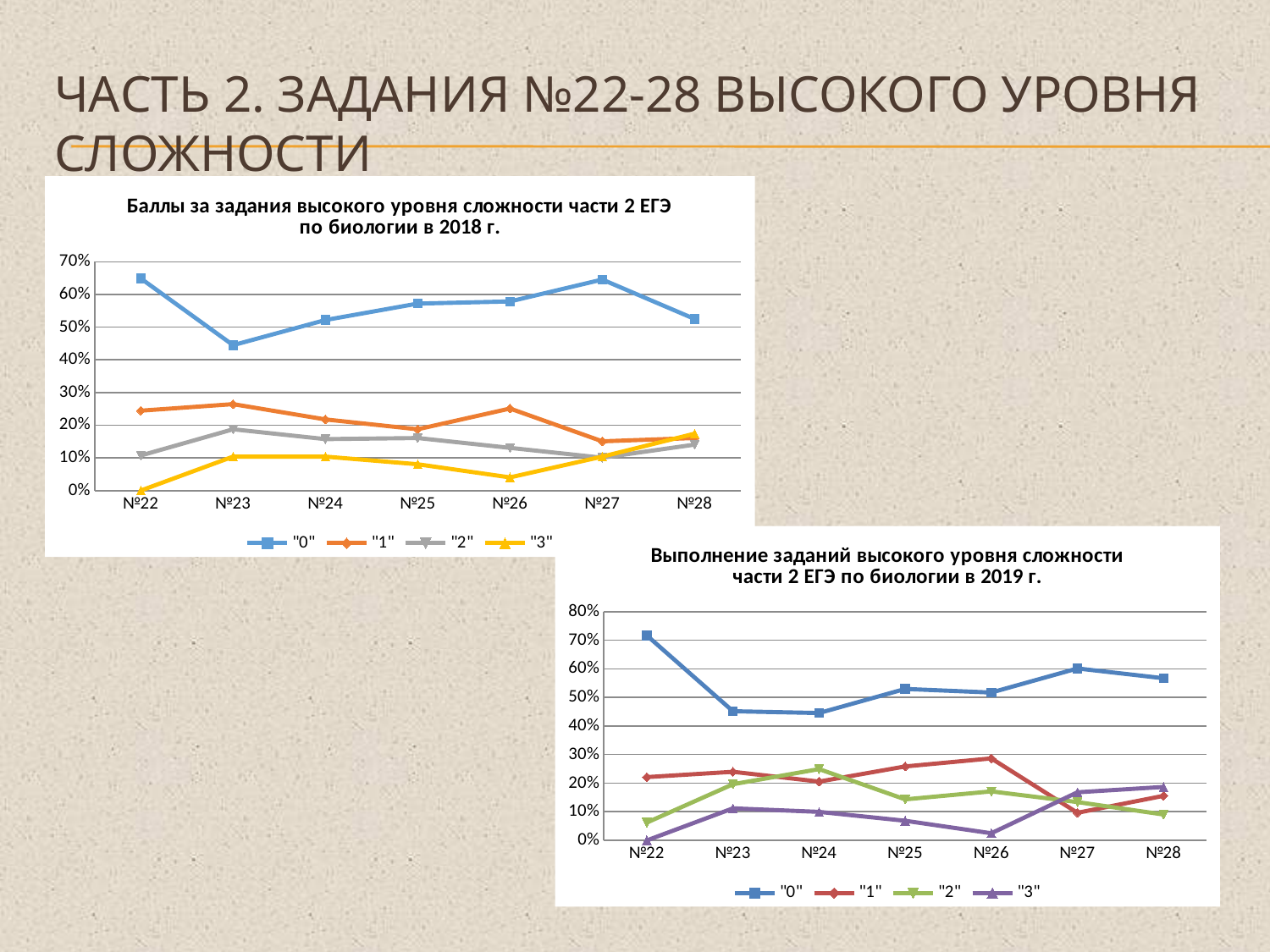
In the lower-right chart (2019), for which task is the value of series "0" highest? №22 What kind of chart is the upper-left chart titled "Баллы за задания высокого уровня сложности части 2 ЕГЭ по биологии в 2018 г."? Line chart How many series does the legend of the lower-right chart (2019) list? 4 How many task categories are shown on the x axis of the upper-left chart (2018)? 7 In the lower-right chart (2019), is the value of series "1" for №26 greater or less than 20%? greater What is the title of the lower-right chart? Выполнение заданий высокого уровня сложности части 2 ЕГЭ по биологии в 2019 г. In the upper-left chart (2018), for which task is the value of series "0" lowest? №23 In the upper-left chart (2018), is the value of series "3" for №22 greater or less than 10%? less In the lower-right chart (2019), which is larger for series "0": the value for №27 or the value for №28? №27 In the upper-left chart (2018), is the value of series "0" for №22 greater or less than 60%? greater In the lower-right chart (2019), for which task is the value of series "3" lowest? №22 In the upper-left chart (2018), which series has the larger value for №23: "1" or "2"? "1"